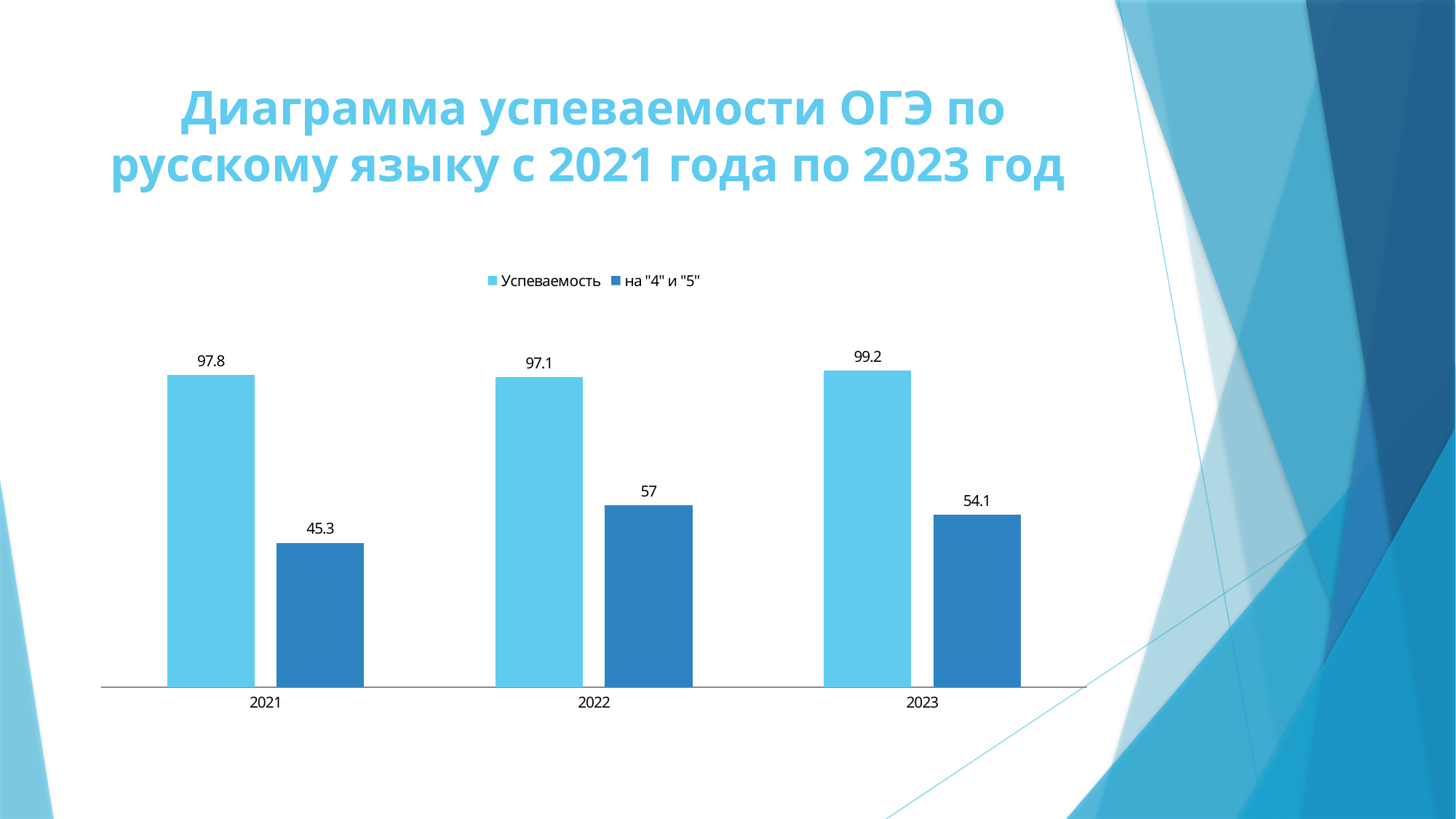
What is the title of the slide? Диаграмма успеваемости ОГЭ по русскому языку с 2021 года по 2023 год Which is larger: на "4" и "5" in 2022 or in 2021? 2022 What is the value of на "4" и "5" for 2022? 57 How many years are shown on the x axis? 3 What is the value of на "4" и "5" for 2023? 54.1 What is the difference between Успеваемость and на "4" и "5" in 2021? 52.5 What is the value of Успеваемость for 2021? 97.8 In which year is Успеваемость highest? 2023 What is the difference between на "4" и "5" in 2022 and in 2023? 2.9 How many series does the legend list? 2 What kind of chart is shown on the slide? Bar chart In which year is на "4" и "5" lowest? 2021